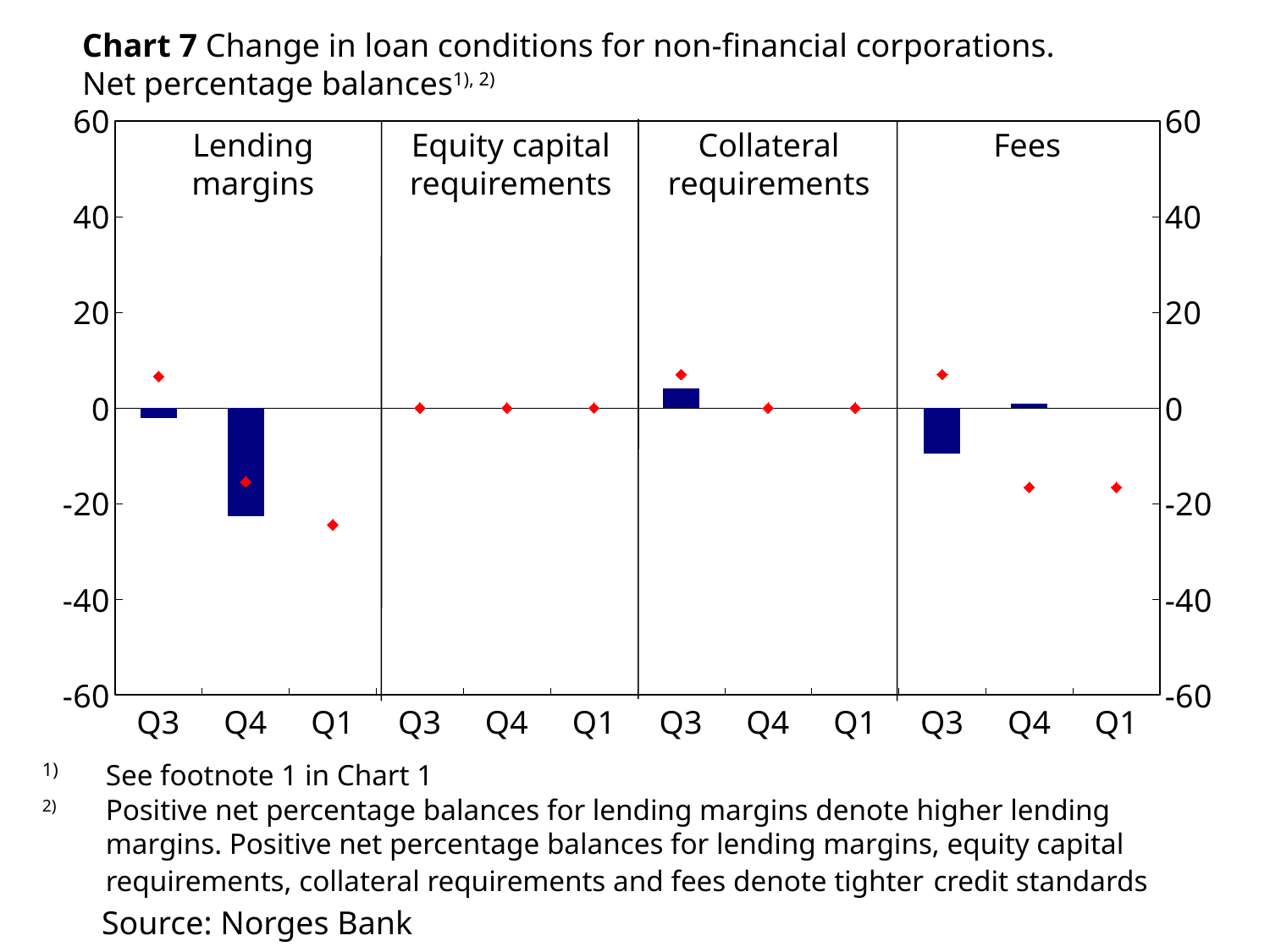
How many loan-condition panels does Chart 7 show? 4 In the Collateral requirements panel, is the bar for Q3 greater or less than 0? greater In the Fees panel, is the red diamond for Q4 greater or less than -20? greater In the Lending margins panel, which quarter has the lowest bar? Q4 How many quarters are shown in each panel of Chart 7? 3 In the Lending margins panel, do the red diamonds rise or fall from Q3 to Q1? fall What kind of chart is Chart 7? combination bar and line chart (bars with red diamond markers) Which is lower: the Q4 bar in the Lending margins panel or the Q3 bar in the Fees panel? Q4 bar in Lending margins In the Fees panel, is the bar for Q3 greater or less than 0? less What is the source given for Chart 7? Norges Bank